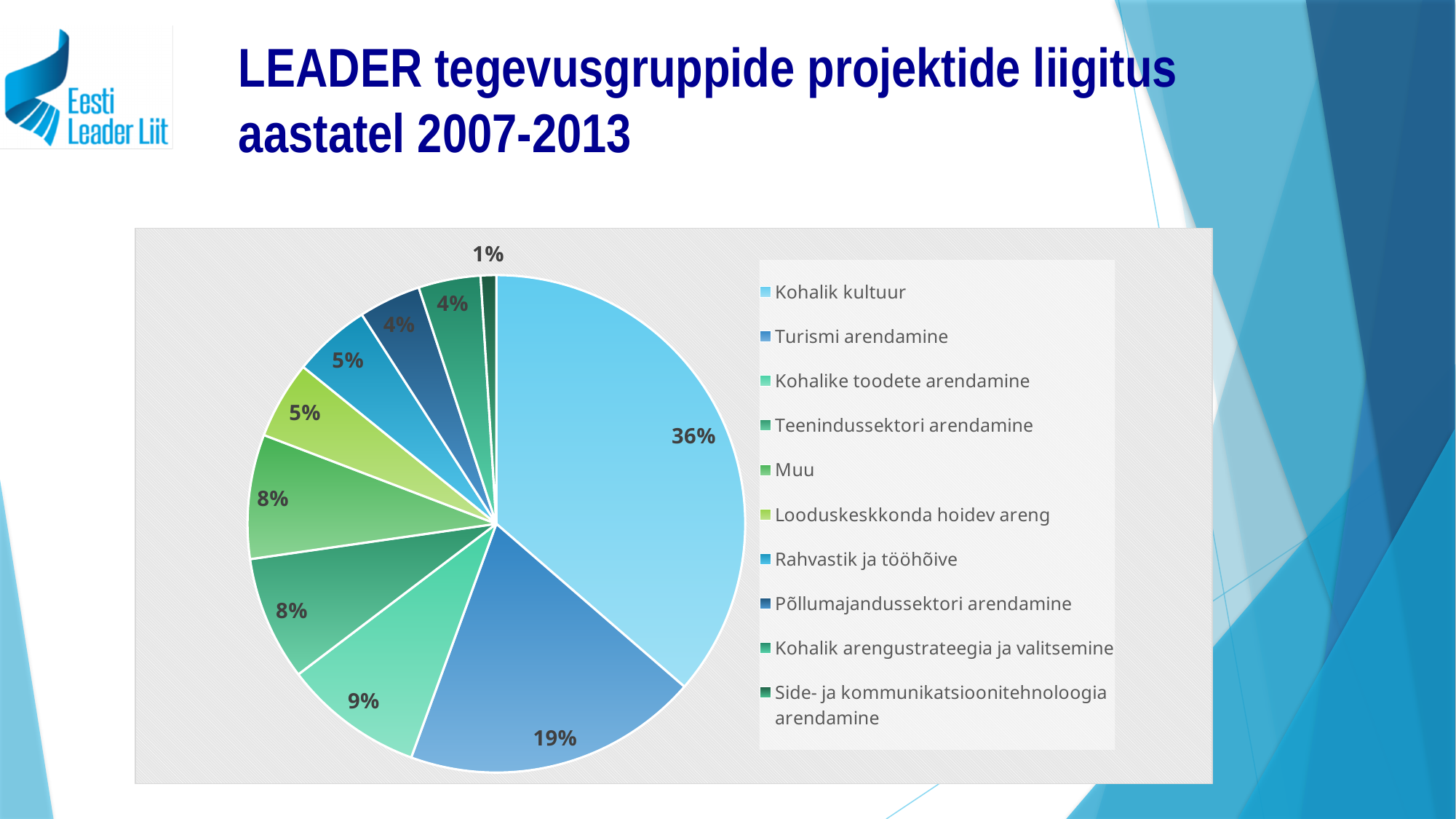
What is the value shown for Põllumajandussektori arendamine? 4% What type of chart is shown on the slide? pie chart What is the value shown for Kohalike toodete arendamine? 9% Which is larger, the slice for Turismi arendamine or the slice for Kohalike toodete arendamine? Turismi arendamine Which category has the largest slice of the pie? Kohalik kultuur What share of the pie does Kohalik kultuur have? 36% How many categories does the pie chart have? 10 What is the value shown for Turismi arendamine? 19% What is the title of the slide containing the pie chart? LEADER tegevusgruppide projektide liigitus aastatel 2007-2013 What is the difference in percentage points between Kohalik kultuur and Turismi arendamine? 17 Which category has the smallest slice of the pie? Side- ja kommunikatsioonitehnoloogia arendamine What is the value shown for Looduskeskkonda hoidev areng? 5%